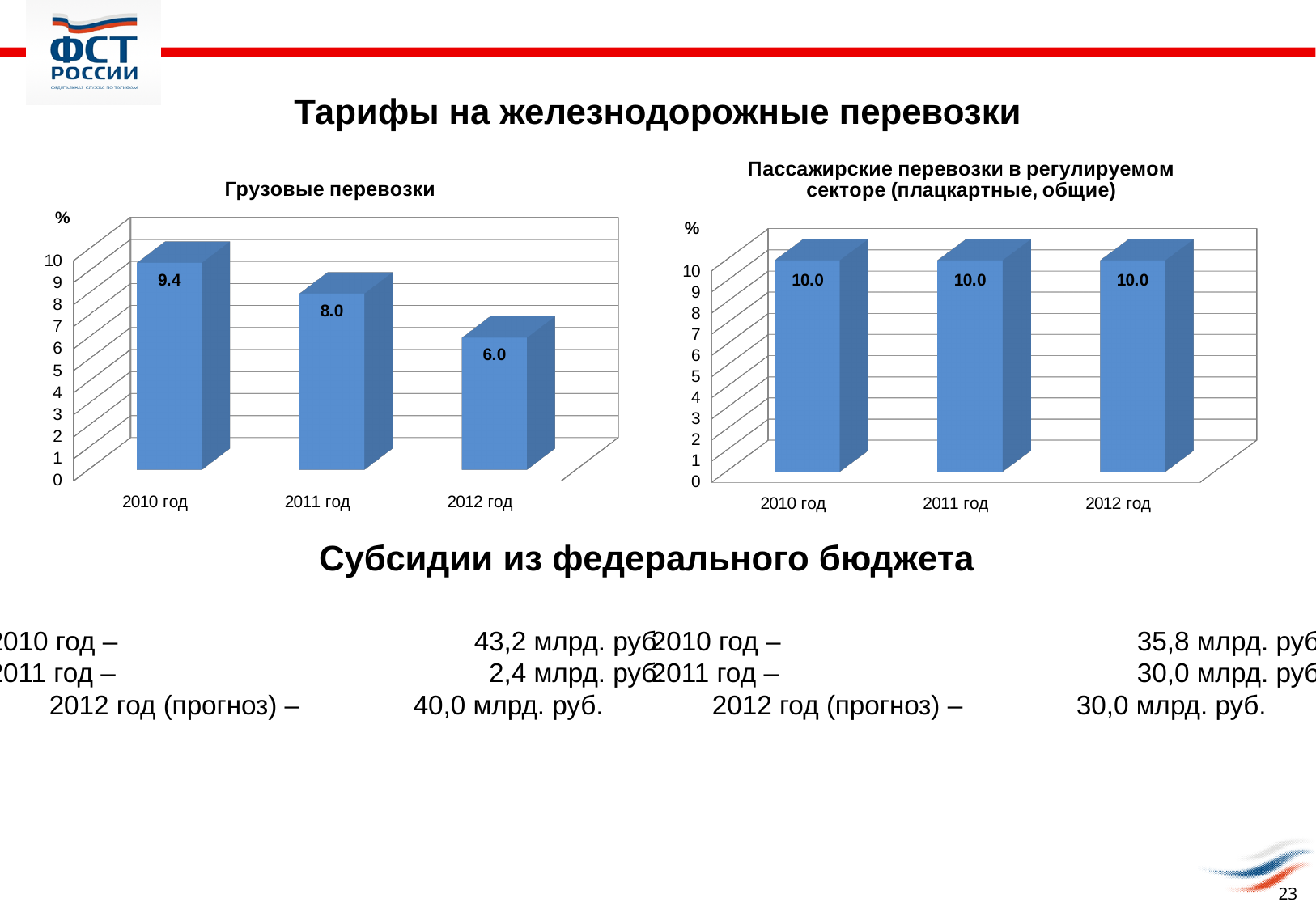
In the 'Грузовые перевозки' chart, which year has the lowest value? 2012 год In the 'Пассажирские перевозки в регулируемом секторе' chart, do the values rise, fall or stay the same from 2010 год to 2012 год? stay the same In the 'Грузовые перевозки' chart, which year has the highest value? 2010 год In the 'Пассажирские перевозки в регулируемом секторе' chart, what is the value for 2011 год? 10.0 What type of chart is the 'Грузовые перевозки' chart? bar chart In the 'Грузовые перевозки' chart, what is the value for 2010 год? 9.4 In the 'Грузовые перевозки' chart, what is the difference between the values for 2010 год and 2012 год? 3.4 In the 'Грузовые перевозки' chart, what is the value for 2012 год? 6.0 In the 'Грузовые перевозки' chart, do the values rise or fall from 2010 год to 2012 год? fall How many years are shown in the 'Грузовые перевозки' chart? 3 Which is larger: the 2012 год value in the 'Грузовые перевозки' chart or the 2012 год value in the 'Пассажирские перевозки в регулируемом секторе' chart? Пассажирские перевозки в регулируемом секторе In the 'Грузовые перевозки' chart, what is the value for 2011 год? 8.0